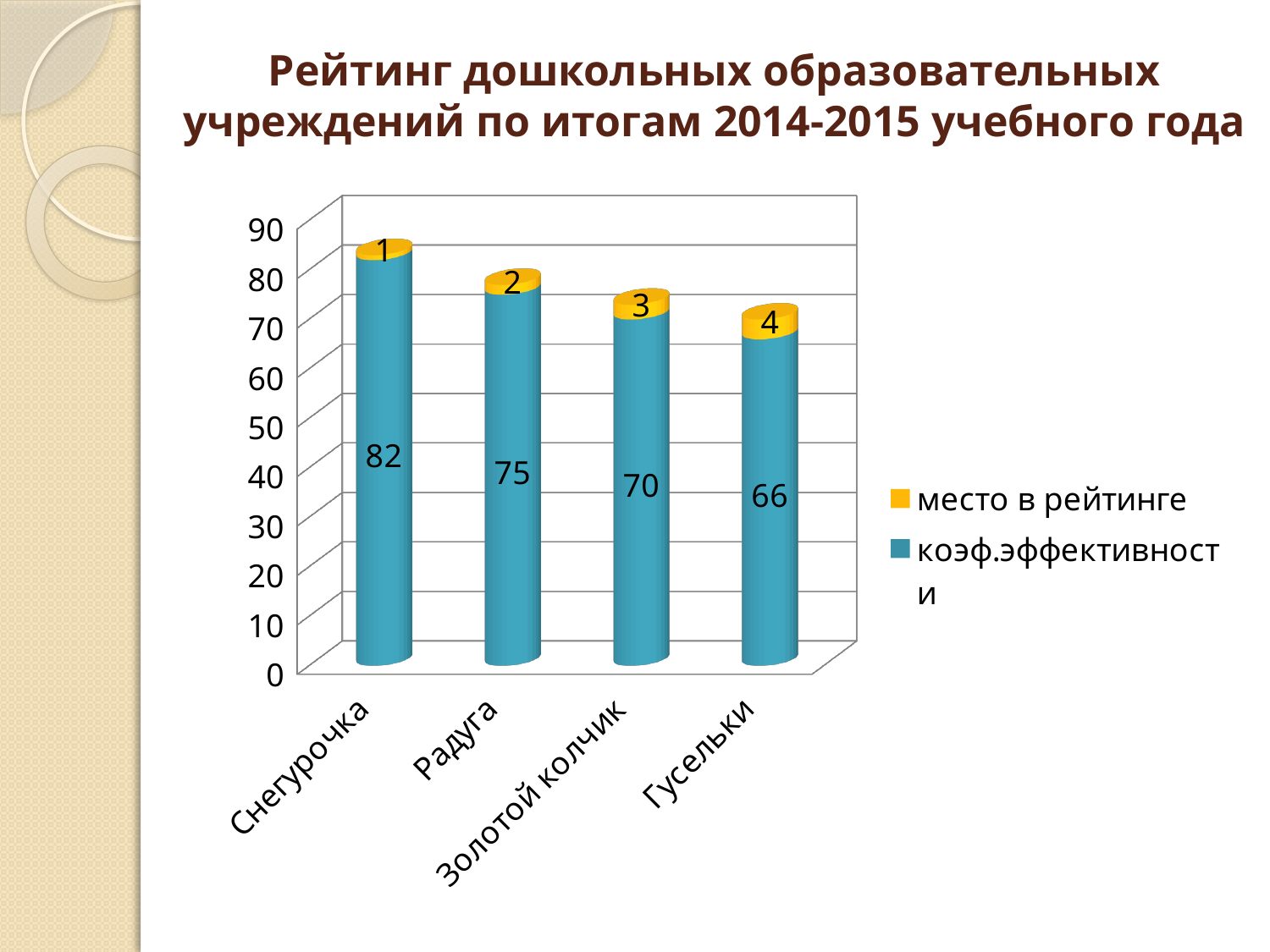
Which category has the lowest коэф.эффективности value? Гусельки How many series does the legend list? 2 How many categories are shown on the x axis? 4 What is the total of the stacked bar for Радуга? 77 What is the коэф.эффективности value for Гусельки? 66 Which category has the highest коэф.эффективности value? Снегурочка What kind of chart is shown on the slide? Stacked bar chart What is the коэф.эффективности value for Снегурочка? 82 Which has a larger коэф.эффективности value, Радуга or Золотой колчик? Радуга What is the difference between the коэф.эффективности values for Снегурочка and Радуга? 7 Do the коэф.эффективности values rise or fall from left to right along the x axis? Fall What is the место в рейтинге value for Золотой колчик? 3